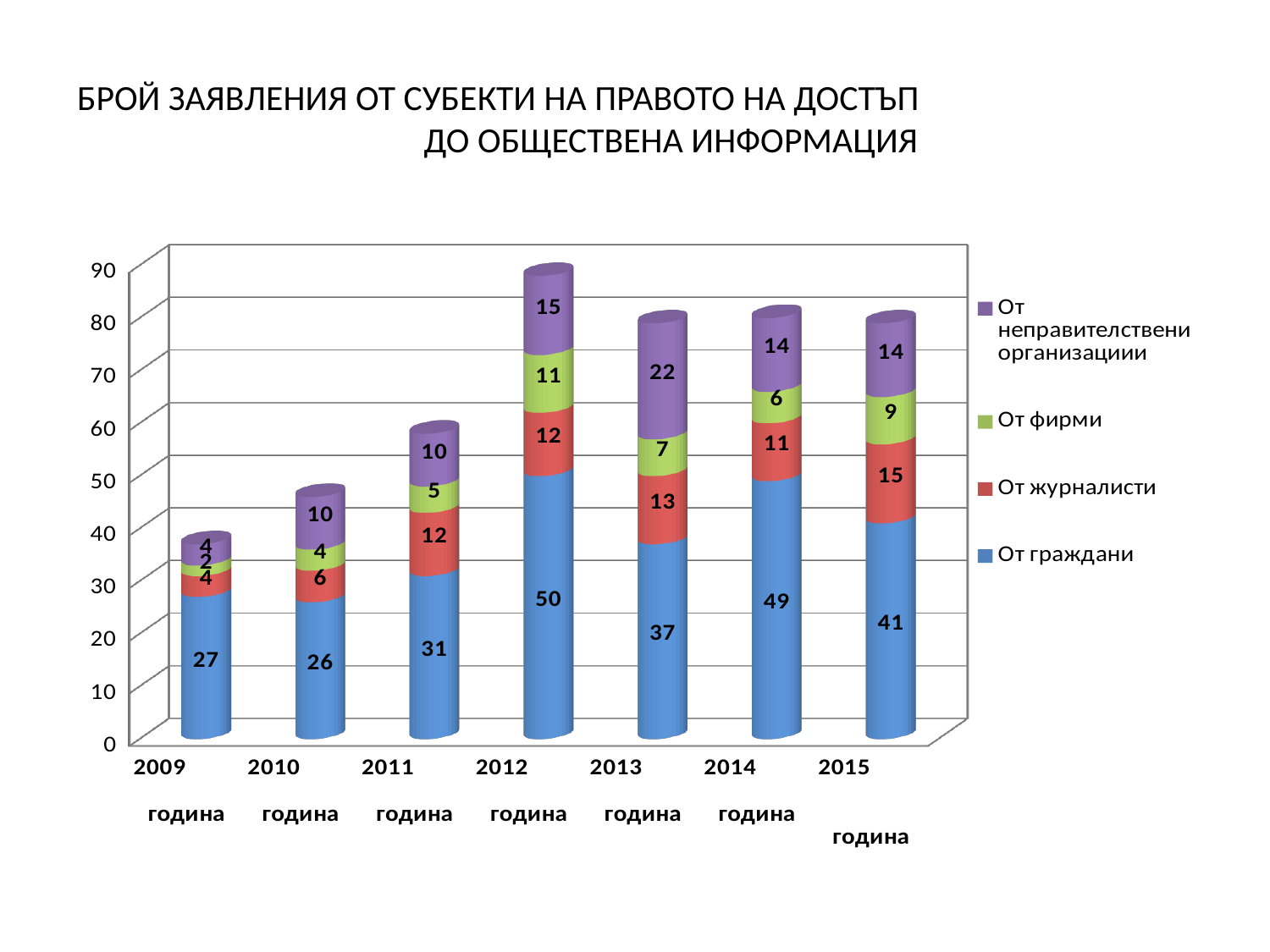
What is the value for 'От неправителствени организациии' in 2013 година? 22 What type of chart is shown on the slide? Stacked bar chart In which year is the 'От фирми' value lowest? 2009 година Which is larger: the 'От неправителствени организациии' value in 2013 година or in 2014 година? 2013 година What is the difference between the 'От граждани' values for 2014 година and 2015 година? 8 What is the value for 'От граждани' in 2012 година? 50 What is the total of the stacked bar for 2012 година? 88 How many series does the legend list? 4 In which year is the 'От граждани' value highest? 2012 година What is the value for 'От фирми' in 2011 година? 5 How many years (categories) are shown on the x axis? 7 What is the value for 'От журналисти' in 2015 година? 15